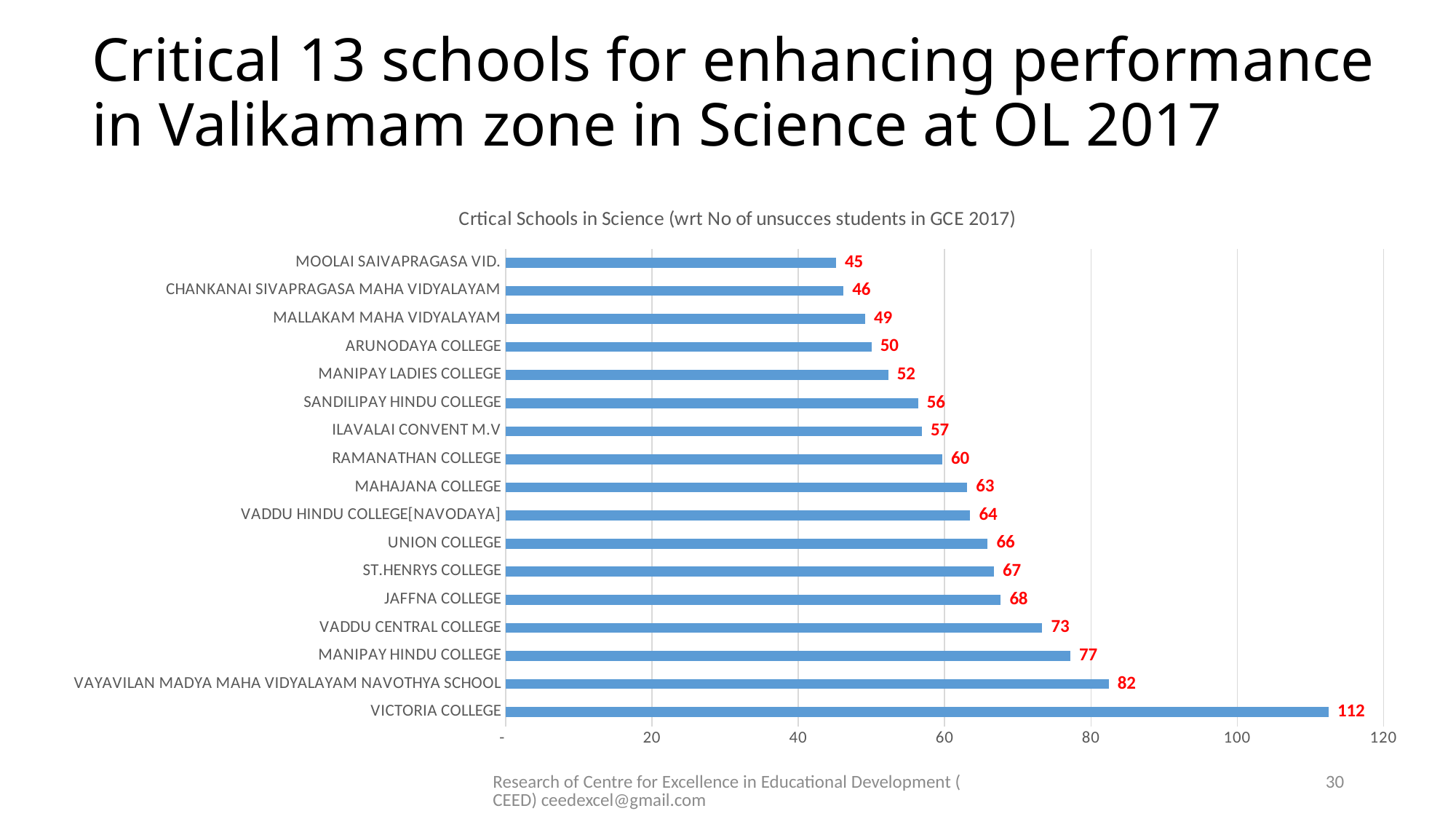
Which school has the highest value? Victoria College What is the difference between the values for Victoria College and Vayavilan Madya Maha Vidyalayam Navothya School? 30 What is the value for Jaffna College? 68 What type of chart is shown on the slide? Bar chart What is the value for Manipay Ladies College? 52 Is the value for Vaddu Central College greater or less than 60? greater What is the value for Victoria College? 112 Which school has the lowest value? Moolai Saivapragasa Vid. How many schools are shown in the chart? 17 What is the difference between the values for Manipay Hindu College and Ramanathan College? 17 What is the title of the chart? Crtical Schools in Science (wrt No of unsucces students in GCE 2017) Which has a larger value, Union College or Sandilipay Hindu College? Union College